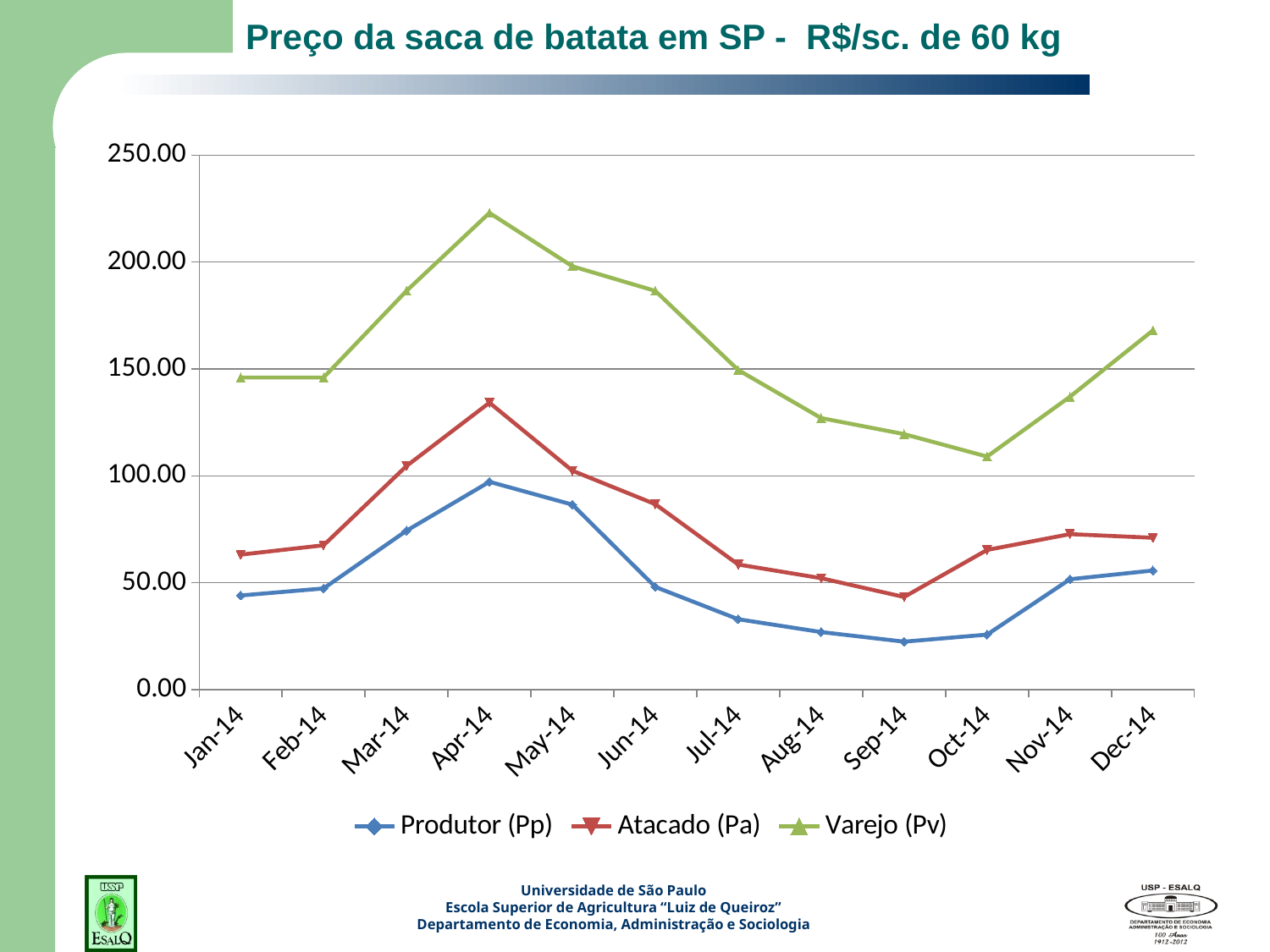
In which month does the Varejo (Pv) series reach its highest value? Apr-14 How many months are plotted along the x axis? 12 How many series does the legend list? 3 Is the value for Varejo (Pv) in Apr-14 greater or less than 200.00? greater Does the Varejo (Pv) series rise or fall from Apr-14 to Oct-14? fall What kind of chart is shown on the slide? line chart Which is larger for Atacado (Pa): the value in Mar-14 or the value in Jul-14? Mar-14 In which month does the Atacado (Pa) series reach its highest value? Apr-14 In which month does the Varejo (Pv) series reach its lowest value? Oct-14 Which series is drawn with the green line and triangle markers? Varejo (Pv) Is the value for Produtor (Pp) in Sep-14 greater or less than 50.00? less In which month does the Produtor (Pp) series reach its lowest value? Sep-14